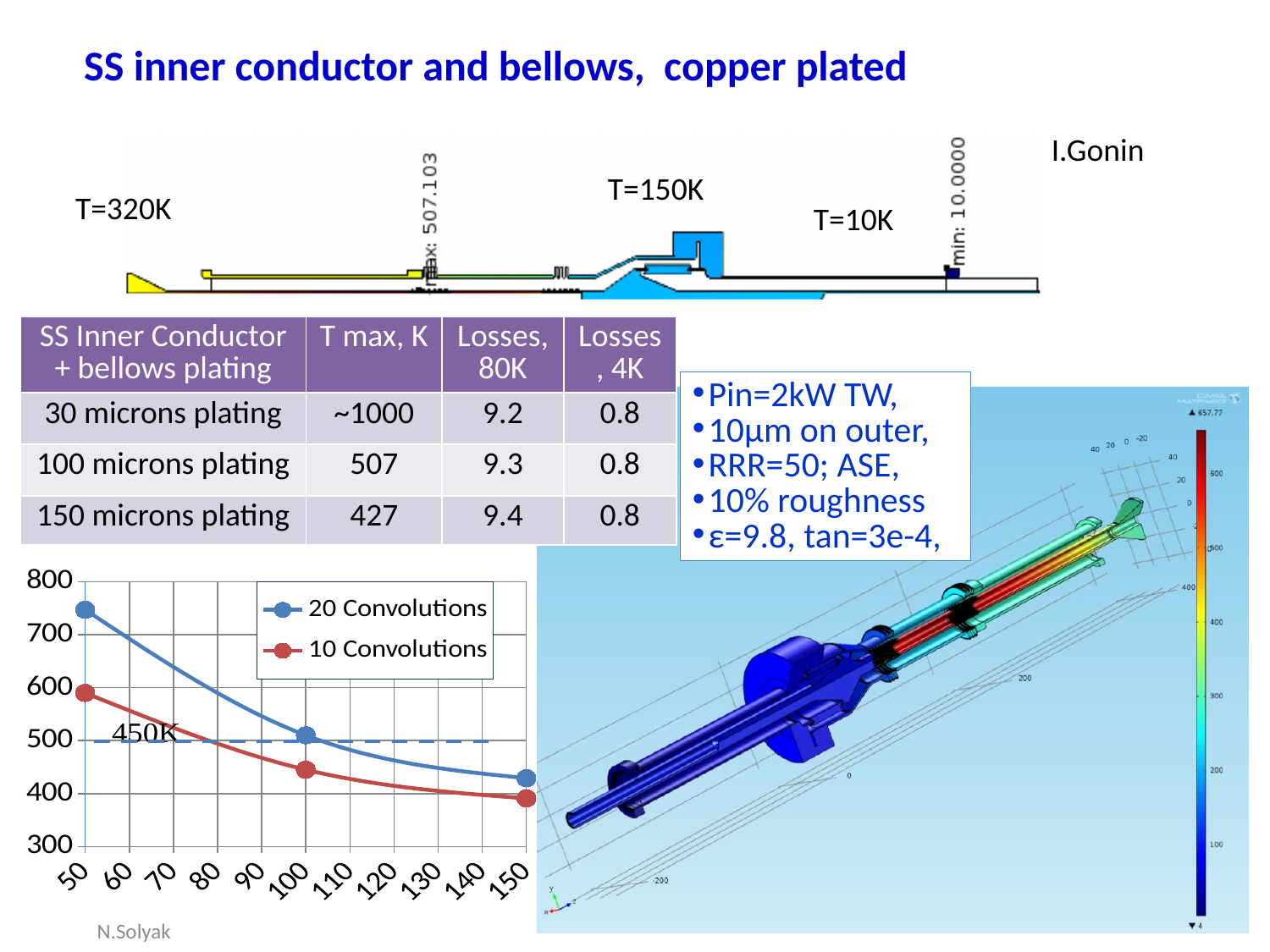
In the line chart, is the value for 20 Convolutions at x=50 greater or less than 700? greater In the line chart, does the 20 Convolutions series rise or fall as the x-axis value increases from 50 to 150? fall In the line chart, at which x value does the 20 Convolutions series reach its highest value? 50 In the line chart, is the value for 20 Convolutions at x=100 greater or less than 600? less In the line chart, which series has the larger value at x=50, 20 Convolutions or 10 Convolutions? 20 Convolutions What are the two series named in the legend of the line chart? 20 Convolutions and 10 Convolutions In the line chart, does the 10 Convolutions series rise or fall along the x axis? fall What kind of chart is shown at the bottom left of the slide? line chart How many data points are plotted for each series in the line chart? 3 How many series does the legend of the line chart list? 2